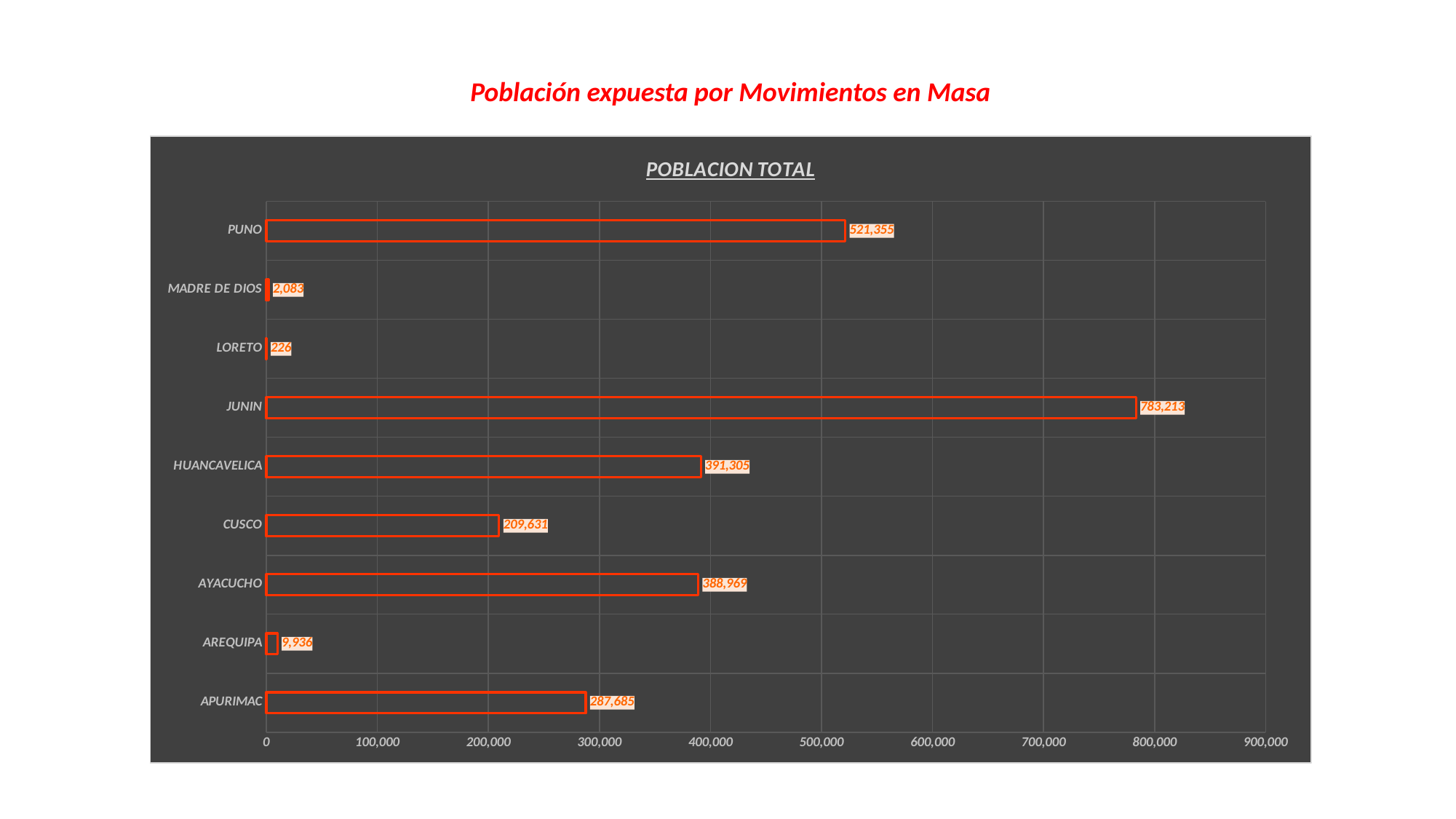
Which is larger, the value for HUANCAVELICA or the value for AYACUCHO? HUANCAVELICA Is the value for CUSCO greater or less than 300,000? less Which category has the highest value? JUNIN How many categories are shown in the chart? 9 What is the title of the chart? POBLACION TOTAL What kind of chart is shown on the slide? bar chart What is the value for PUNO? 521,355 What is the value for LORETO? 226 What is the difference between the values for JUNIN and PUNO? 261,858 What is the value for JUNIN? 783,213 What is the value for APURIMAC? 287,685 Which category has the lowest value? LORETO